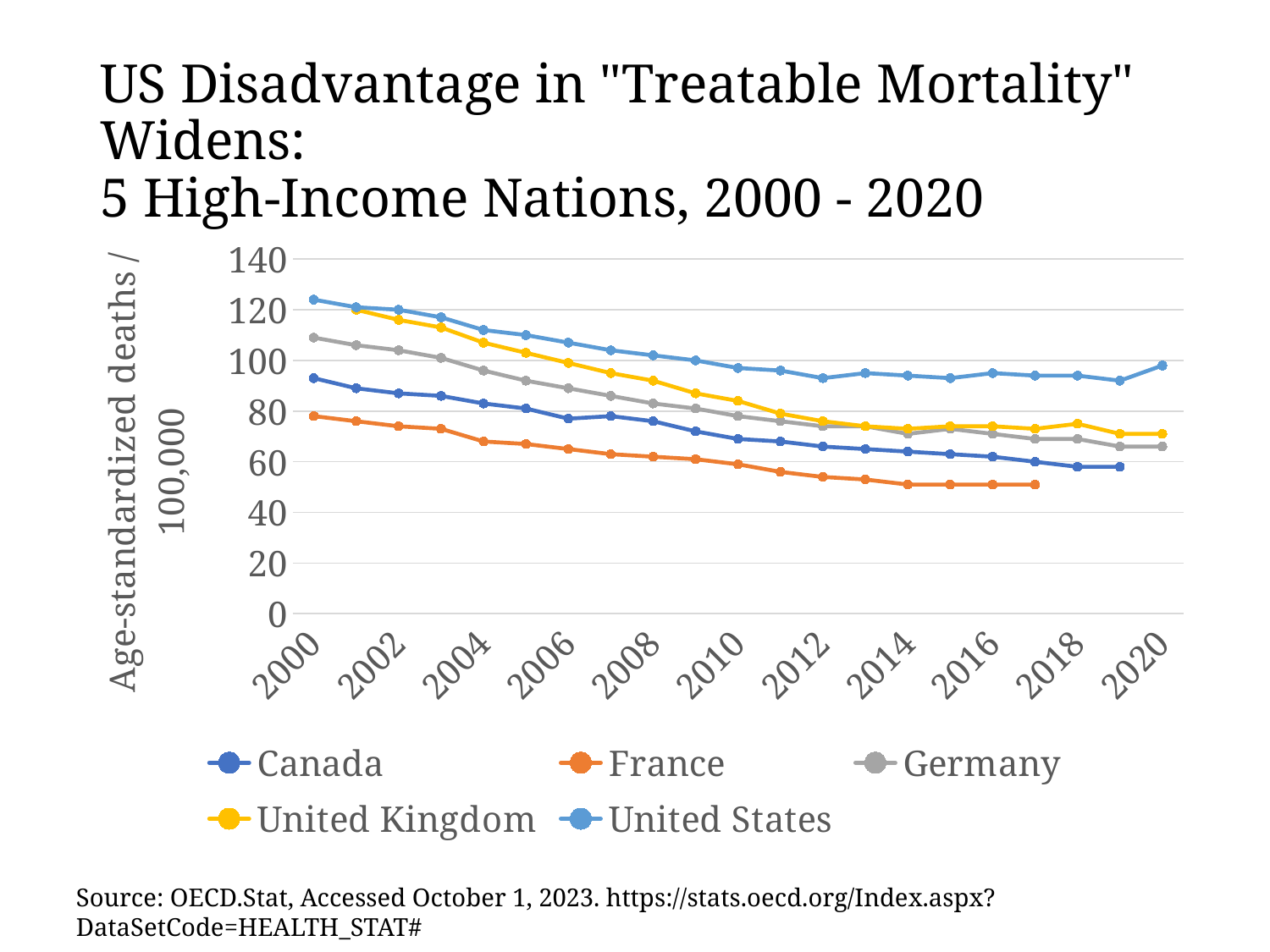
What kind of chart is shown on the slide? line chart How many series does the legend list? 5 Is the value for the United States in 2000 greater or less than 120? greater What is the label on the vertical axis? Age-standardized deaths / 100,000 Is the value for Germany in 2000 greater or less than 100? greater Does the value for Canada rise or fall from 2000 to 2020? fall Which countries are listed in the legend? Canada, France, Germany, United Kingdom, United States Is the value for the United Kingdom in 2020 greater or less than 80? less Which country has the highest value in 2020? United States In 2000, which is larger, the value for Canada or the value for France? Canada Which country has the lowest value in 2000? France